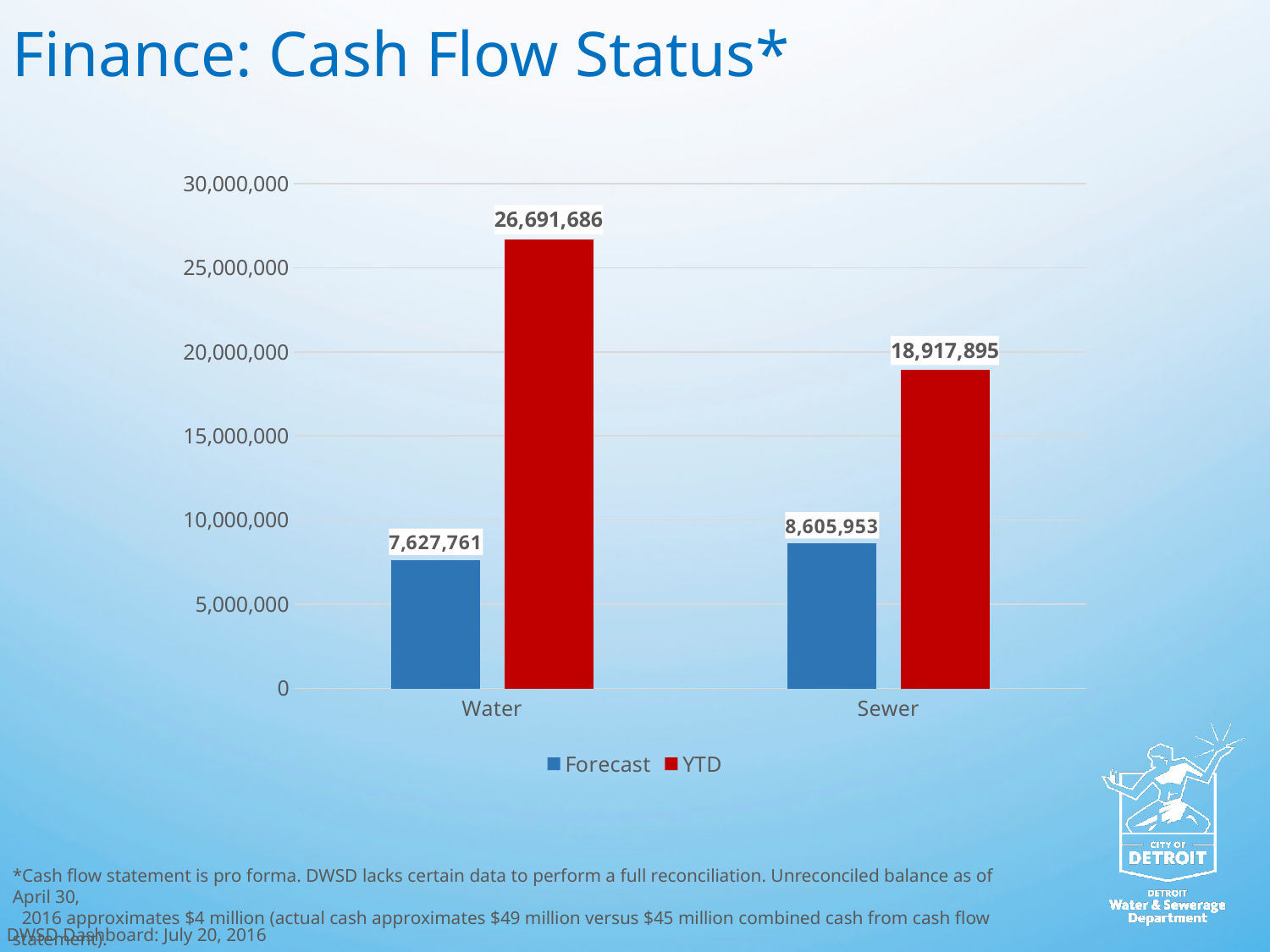
What is the difference between the YTD values for Water and Sewer? 7,773,791 How many series does the legend list? 2 What is the Forecast value for Sewer? 8,605,953 Which category has the highest YTD value? Water What is the difference between the YTD and Forecast values for Water? 19,063,925 What is the YTD value for Water? 26,691,686 Which category has the lowest Forecast value? Water Which is larger for Sewer, the Forecast value or the YTD value? YTD How many categories are shown on the x axis? 2 What is the YTD value for Sewer? 18,917,895 What kind of chart is shown on the slide? Bar chart What is the Forecast value for Water? 7,627,761